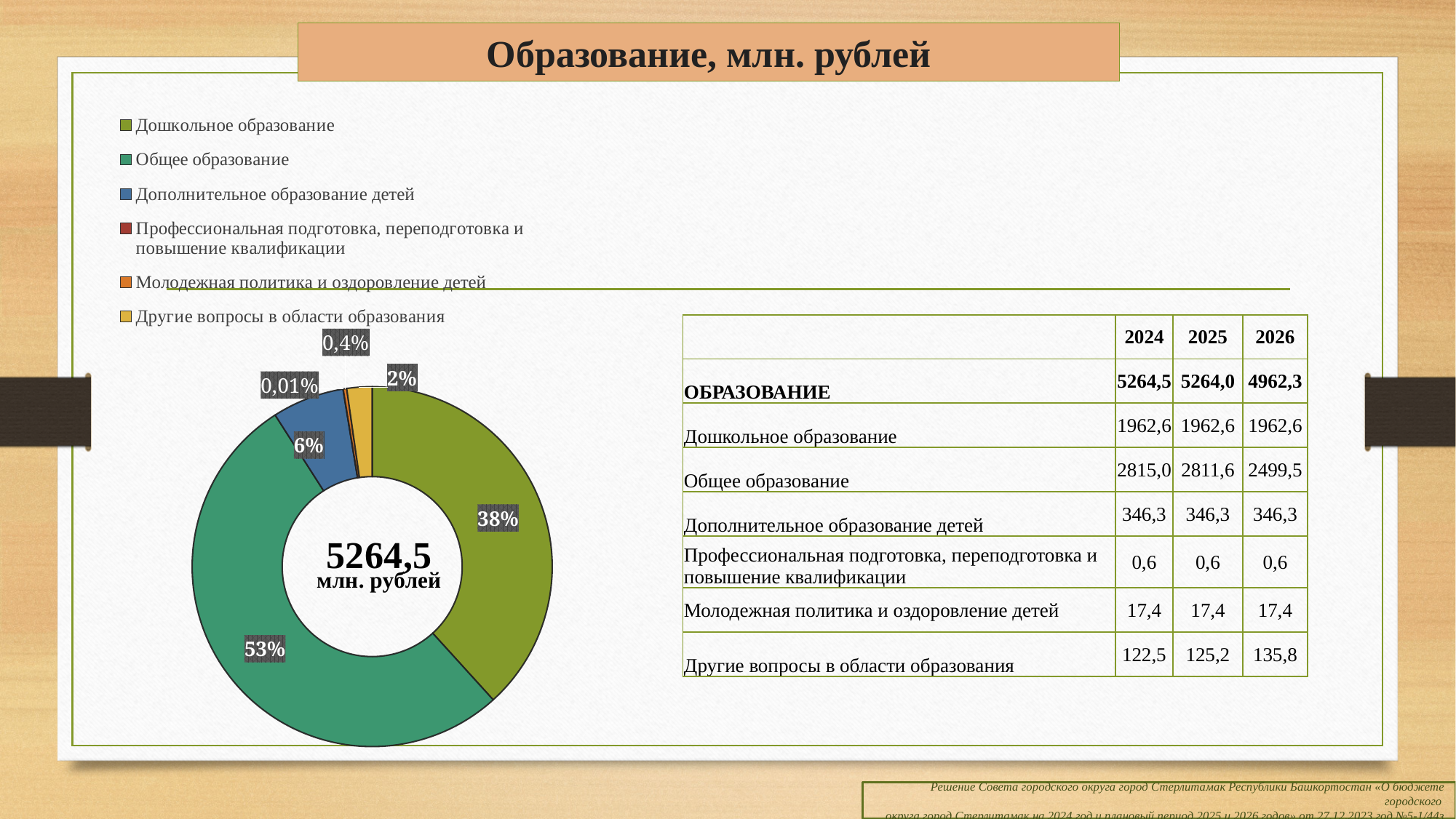
What kind of chart is shown on the slide? Doughnut (pie) chart What total value is shown in the centre of the doughnut chart? 5264,5 млн. рублей Which category has the largest slice in the doughnut chart? Общее образование What share of the doughnut chart does Дополнительное образование детей take? 6% How many categories does the legend of the doughnut chart list? 6 What share of the doughnut chart does Профессиональная подготовка, переподготовка и повышение квалификации take? 0,01% What share of the doughnut chart does Другие вопросы в области образования take? 2% Which slice is larger in the doughnut chart: Дошкольное образование or Дополнительное образование детей? Дошкольное образование Which category has the smallest slice in the doughnut chart? Профессиональная подготовка, переподготовка и повышение квалификации